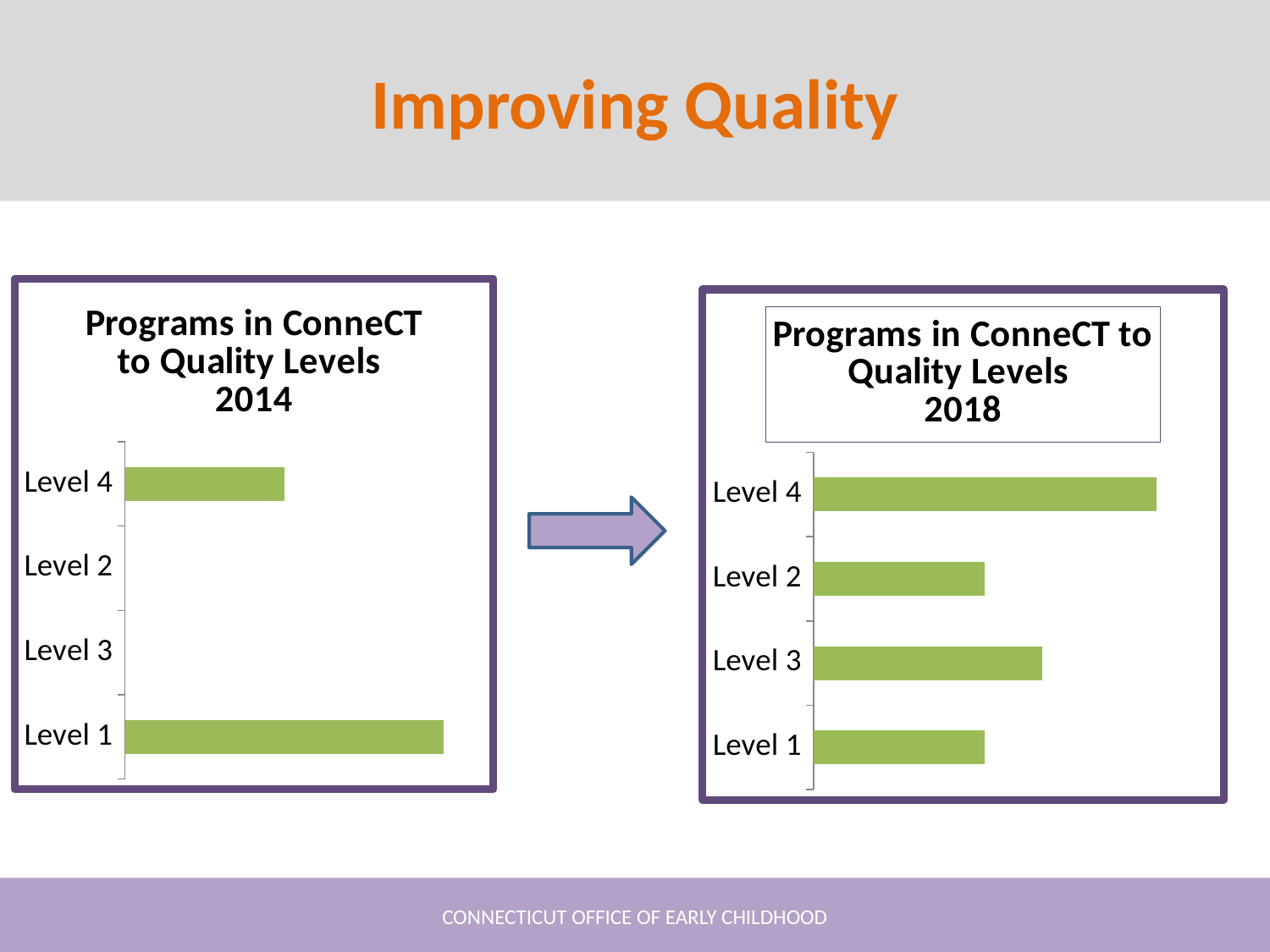
In the 'Programs in ConneCT to Quality Levels 2014' chart, how many quality levels are listed on the axis? 4 What kind of chart is the 'Programs in ConneCT to Quality Levels 2018' chart? Bar chart In the 'Programs in ConneCT to Quality Levels 2014' chart, which level has the longest bar? Level 1 In the 'Programs in ConneCT to Quality Levels 2018' chart, how many quality levels are listed on the axis? 4 What is the title of the chart on the left side of the slide? Programs in ConneCT to Quality Levels 2014 In the 'Programs in ConneCT to Quality Levels 2018' chart, which is larger, Level 3 or Level 2? Level 3 In the 'Programs in ConneCT to Quality Levels 2018' chart, which level has the longest bar? Level 4 In the 'Programs in ConneCT to Quality Levels 2014' chart, which is larger, Level 4 or Level 1? Level 1 What kind of chart is the 'Programs in ConneCT to Quality Levels 2014' chart? Bar chart In the 'Programs in ConneCT to Quality Levels 2018' chart, which is larger, Level 4 or Level 3? Level 4 In the 'Programs in ConneCT to Quality Levels 2014' chart, which levels show no visible bar? Level 2 and Level 3